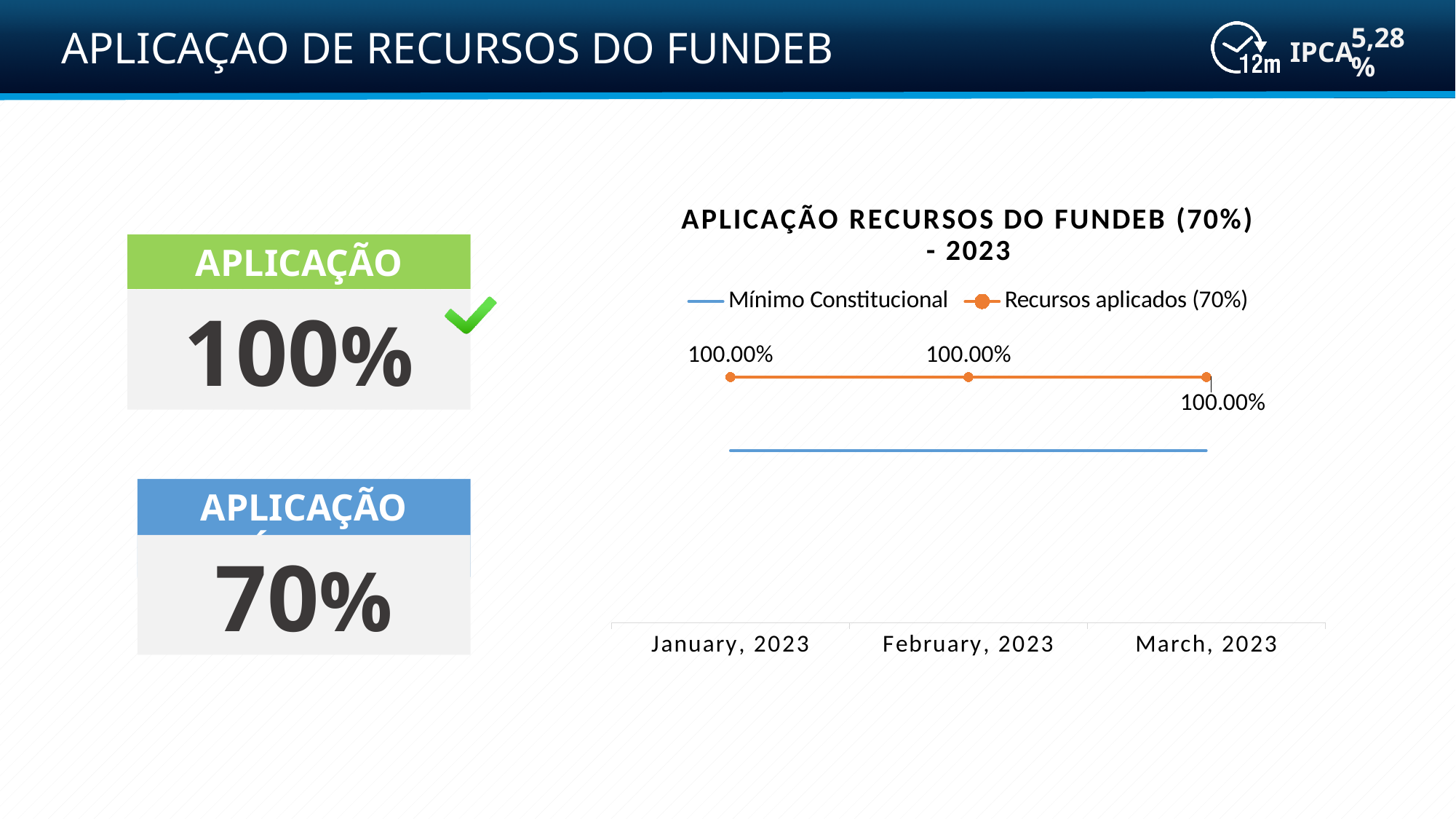
What is the value of Recursos aplicados (70%) for January, 2023? 100.00% Which month is the first category on the x axis of the chart? January, 2023 What is the difference between the Recursos aplicados (70%) values for January, 2023 and March, 2023? 0.00% What is the title of the chart? APLICAÇÃO RECURSOS DO FUNDEB (70%) - 2023 What is the value of Recursos aplicados (70%) for February, 2023? 100.00% How many series does the chart legend list? 2 How many months are shown on the x axis of the chart? 3 Does the Recursos aplicados (70%) series rise, fall, or stay flat from January, 2023 to March, 2023? stays flat What type of chart is shown on the slide? line chart What is the value of Recursos aplicados (70%) for March, 2023? 100.00% What are the two series named in the chart legend? Mínimo Constitucional and Recursos aplicados (70%) In February, 2023, which series is plotted higher: Mínimo Constitucional or Recursos aplicados (70%)? Recursos aplicados (70%)